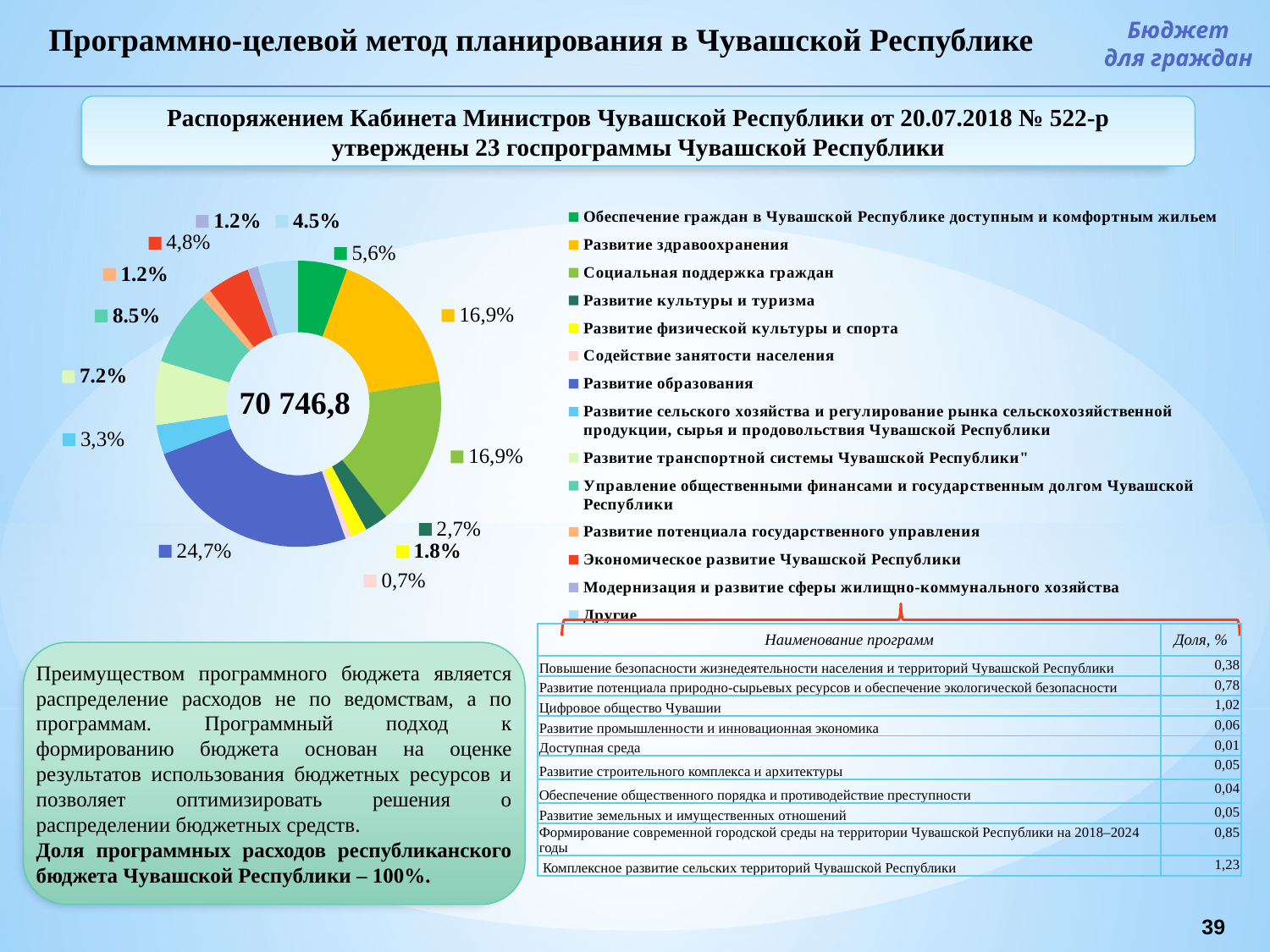
What share is shown for the slice labelled Другие? 4.5% What is the share of the largest slice in the doughnut chart? 24,7% Which programme has the largest share in the doughnut chart? Развитие образования What type of chart is shown on the slide? Doughnut (pie) chart What share is shown for Управление общественными финансами и государственным долгом Чувашской Республики? 8.5% Which programme has the smallest share in the doughnut chart? Содействие занятости населения What share is shown for Экономическое развитие Чувашской Республики? 4,8% What is the difference between the share for Развитие образования (24,7%) and the share for Развитие здравоохранения (16,9%)? 7,8 percentage points How many entries does the legend of the doughnut chart list? 14 What value is printed in the centre of the doughnut chart? 70 746,8 What share is shown for Развитие здравоохранения? 16,9% Which is larger: the share for Развитие транспортной системы or the share for Развитие сельского хозяйства? Развитие транспортной системы